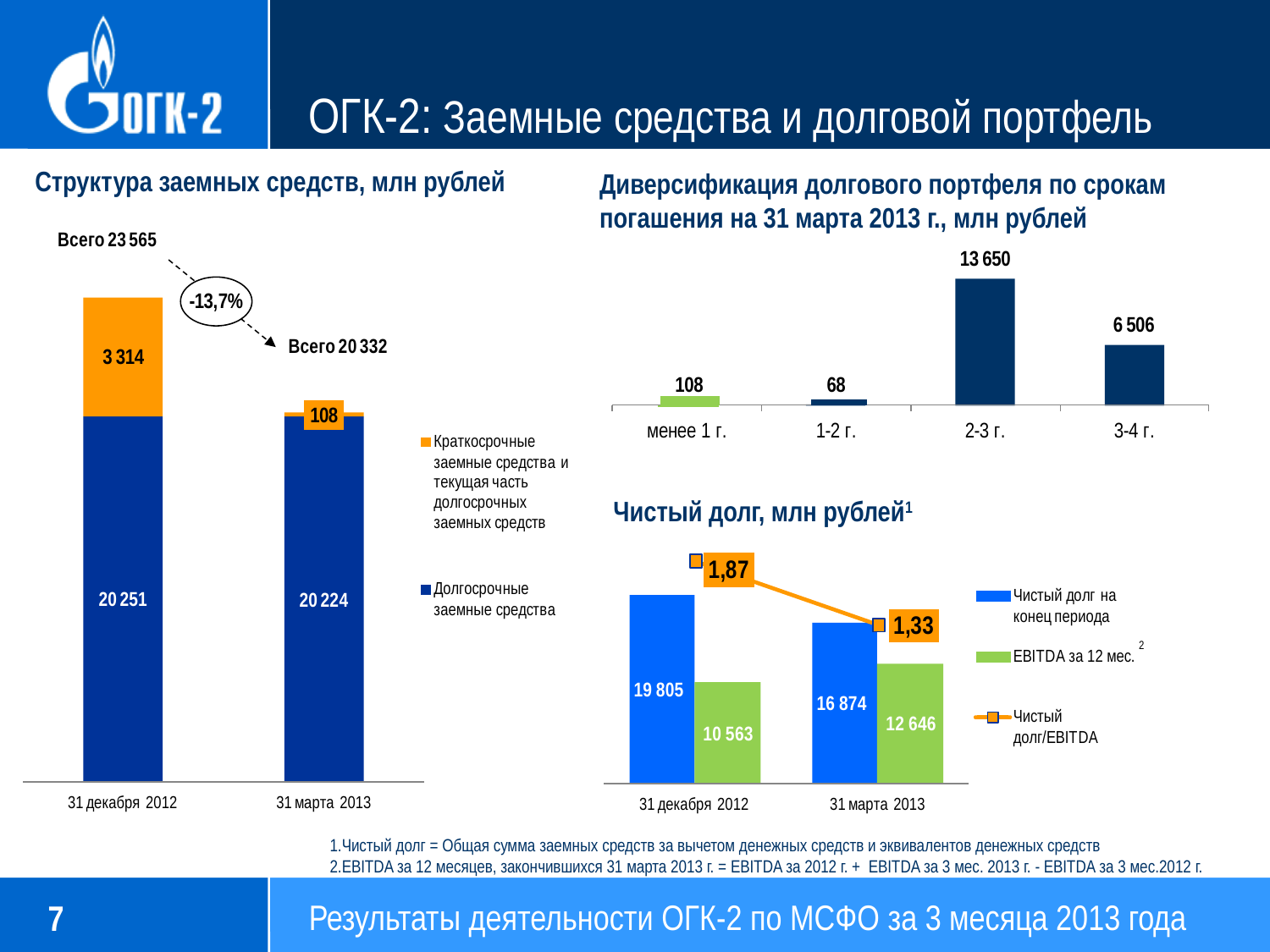
In the chart 'Структура заемных средств, млн рублей', what is the difference between the short-term borrowings (Краткосрочные заемные средства) for 31 декабря 2012 and 31 марта 2013? 3 206 In the chart 'Диверсификация долгового портфеля по срокам погашения', what is the difference between the values for '2-3 г.' and '3-4 г.'? 7 144 In the chart 'Структура заемных средств, млн рублей', what is the total of the stacked bar for 31 декабря 2012? 23 565 In the chart 'Диверсификация долгового портфеля по срокам погашения', how many maturity categories are shown? 4 In the chart 'Чистый долг, млн рублей', what is the value of 'EBITDA за 12 мес.' for 31 марта 2013? 12 646 In the chart 'Диверсификация долгового портфеля по срокам погашения', which maturity category has the highest value? 2-3 г. In the chart 'Структура заемных средств, млн рублей', how many series does the legend list? 2 In the chart 'Чистый долг, млн рублей', which is larger: net debt (Чистый долг) for 31 декабря 2012 or for 31 марта 2013? 31 декабря 2012 In the chart 'Диверсификация долгового портфеля по срокам погашения', which maturity category has the lowest value? 1-2 г. In the chart 'Диверсификация долгового портфеля по срокам погашения', what is the value for '3-4 г.'? 6 506 In the chart 'Чистый долг, млн рублей', does the 'Чистый долг/EBITDA' ratio rise or fall from 31 декабря 2012 to 31 марта 2013? fall In the chart 'Структура заемных средств, млн рублей', what is the value of 'Долгосрочные заемные средства' for 31 марта 2013? 20 224